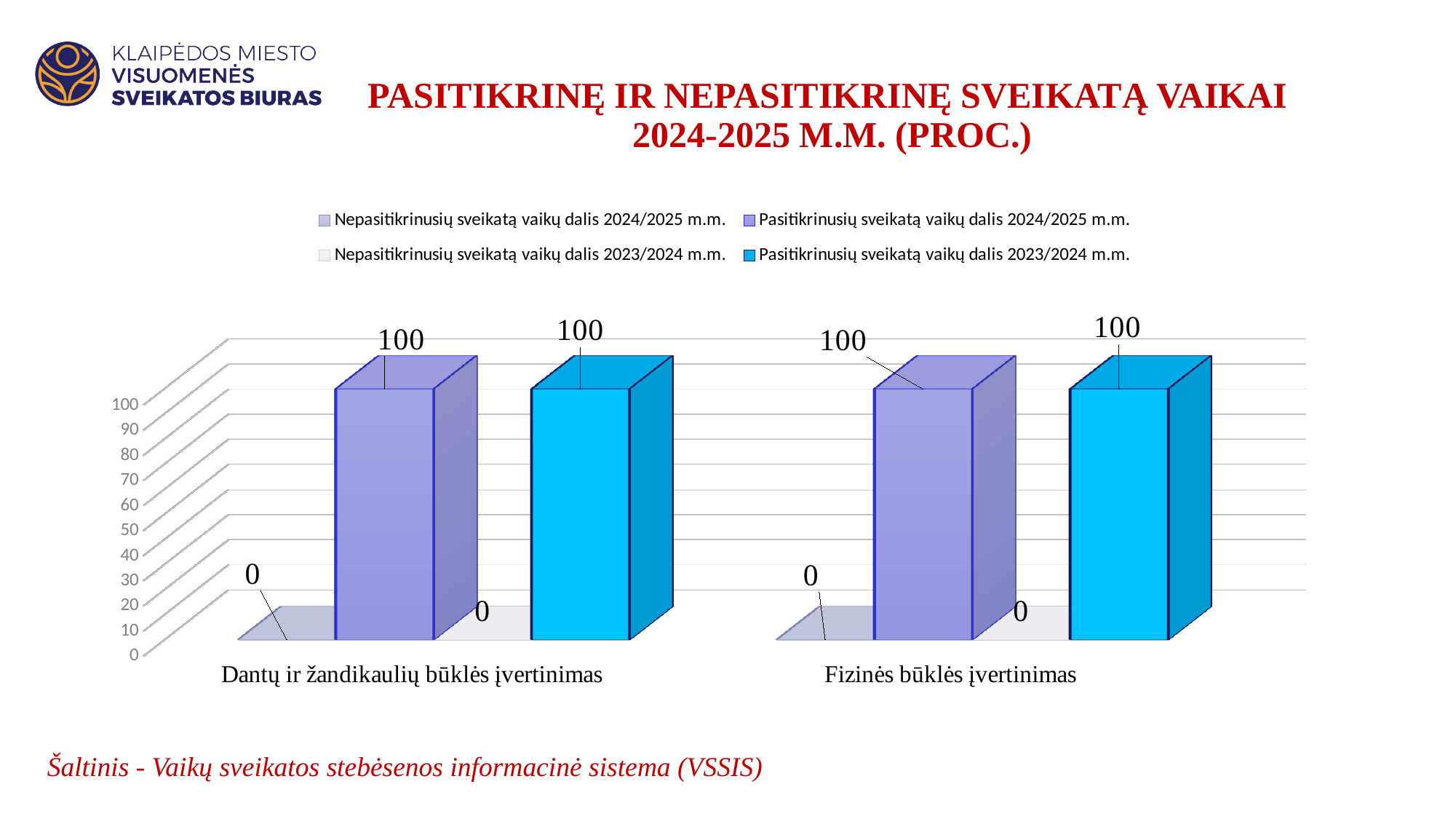
How many series does the legend list? 4 For 'Dantų ir žandikaulių būklės įvertinimas', which is larger: 'Pasitikrinusių sveikatą vaikų dalis 2023/2024 m.m.' or 'Nepasitikrinusių sveikatą vaikų dalis 2023/2024 m.m.'? Pasitikrinusių sveikatą vaikų dalis 2023/2024 m.m. What is the value of 'Pasitikrinusių sveikatą vaikų dalis 2024/2025 m.m.' for 'Dantų ir žandikaulių būklės įvertinimas'? 100 Is the value of 'Pasitikrinusių sveikatą vaikų dalis 2024/2025 m.m.' for 'Fizinės būklės įvertinimas' greater or less than 50? greater What is the value of 'Pasitikrinusių sveikatą vaikų dalis 2023/2024 m.m.' for 'Fizinės būklės įvertinimas'? 100 What kind of chart is shown on the slide? bar chart What is the highest value shown on the vertical axis? 100 What is the value of 'Nepasitikrinusių sveikatą vaikų dalis 2023/2024 m.m.' for 'Dantų ir žandikaulių būklės įvertinimas'? 0 What is the value of 'Nepasitikrinusių sveikatą vaikų dalis 2024/2025 m.m.' for 'Fizinės būklės įvertinimas'? 0 What is the title of the chart on the slide? PASITIKRINĘ IR NEPASITIKRINĘ SVEIKATĄ VAIKAI 2024-2025 M.M. (PROC.) How many categories are shown on the x axis? 2 What is the difference between 'Pasitikrinusių sveikatą vaikų dalis 2024/2025 m.m.' and 'Nepasitikrinusių sveikatą vaikų dalis 2024/2025 m.m.' for 'Fizinės būklės įvertinimas'? 100